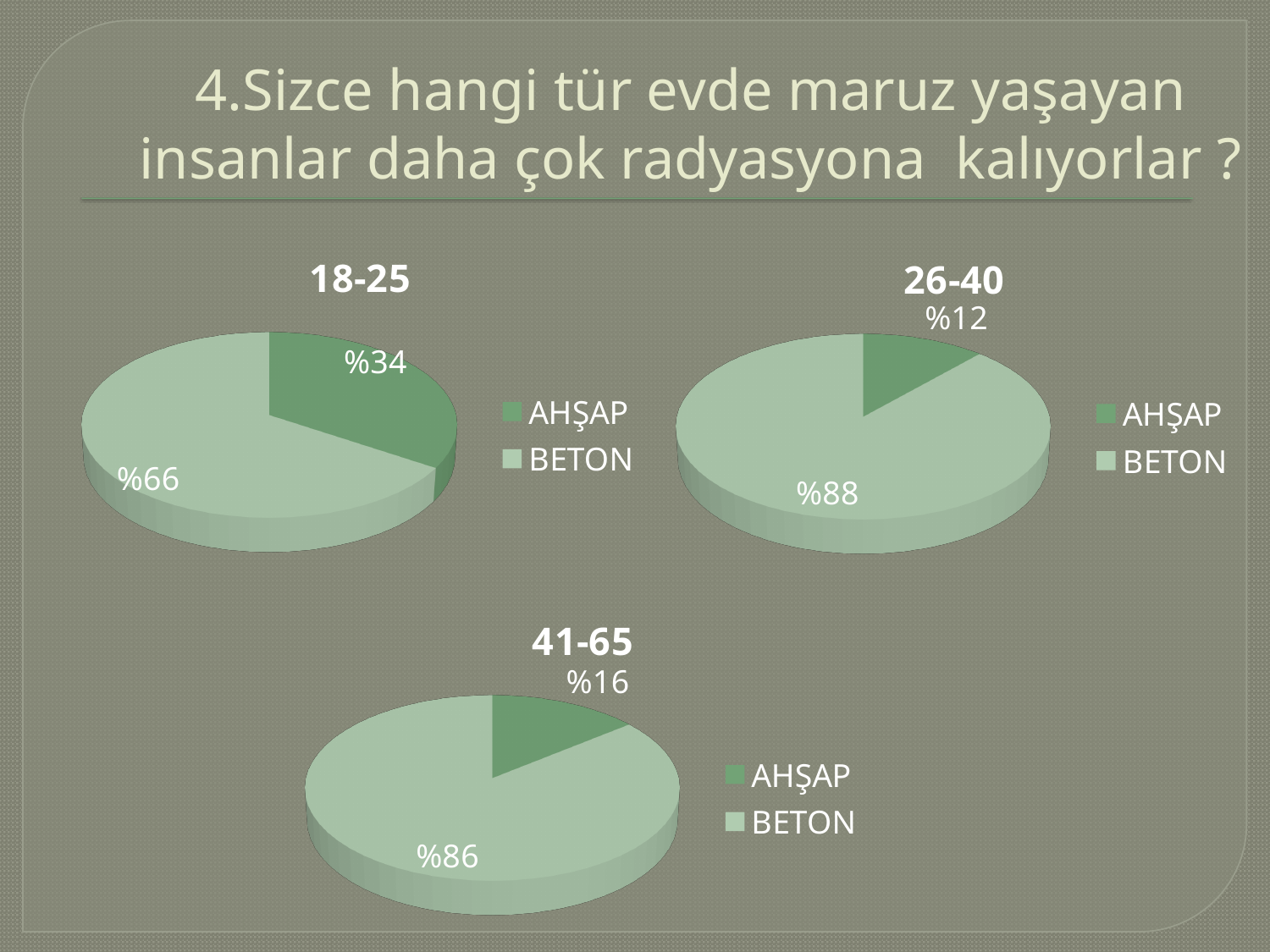
In the "18-25" chart, which category has the largest slice? BETON In the "41-65" chart, what is the value for AHŞAP? %16 In the "41-65" chart, what is the value for BETON? %86 In the "26-40" chart, which category has the smallest slice? AHŞAP In the "18-25" chart, what is the value for BETON? %66 How many entries does the legend of the "26-40" chart list? 2 In the "18-25" chart, what is the difference between the BETON and AHŞAP values? %32 In the "26-40" chart, what is the value for BETON? %88 What kind of chart is the "41-65" chart? Pie chart In the "18-25" chart, what is the value for AHŞAP? %34 In the "26-40" chart, what is the value for AHŞAP? %12 Which is larger: the AHŞAP value in the "18-25" chart or the AHŞAP value in the "41-65" chart? 18-25